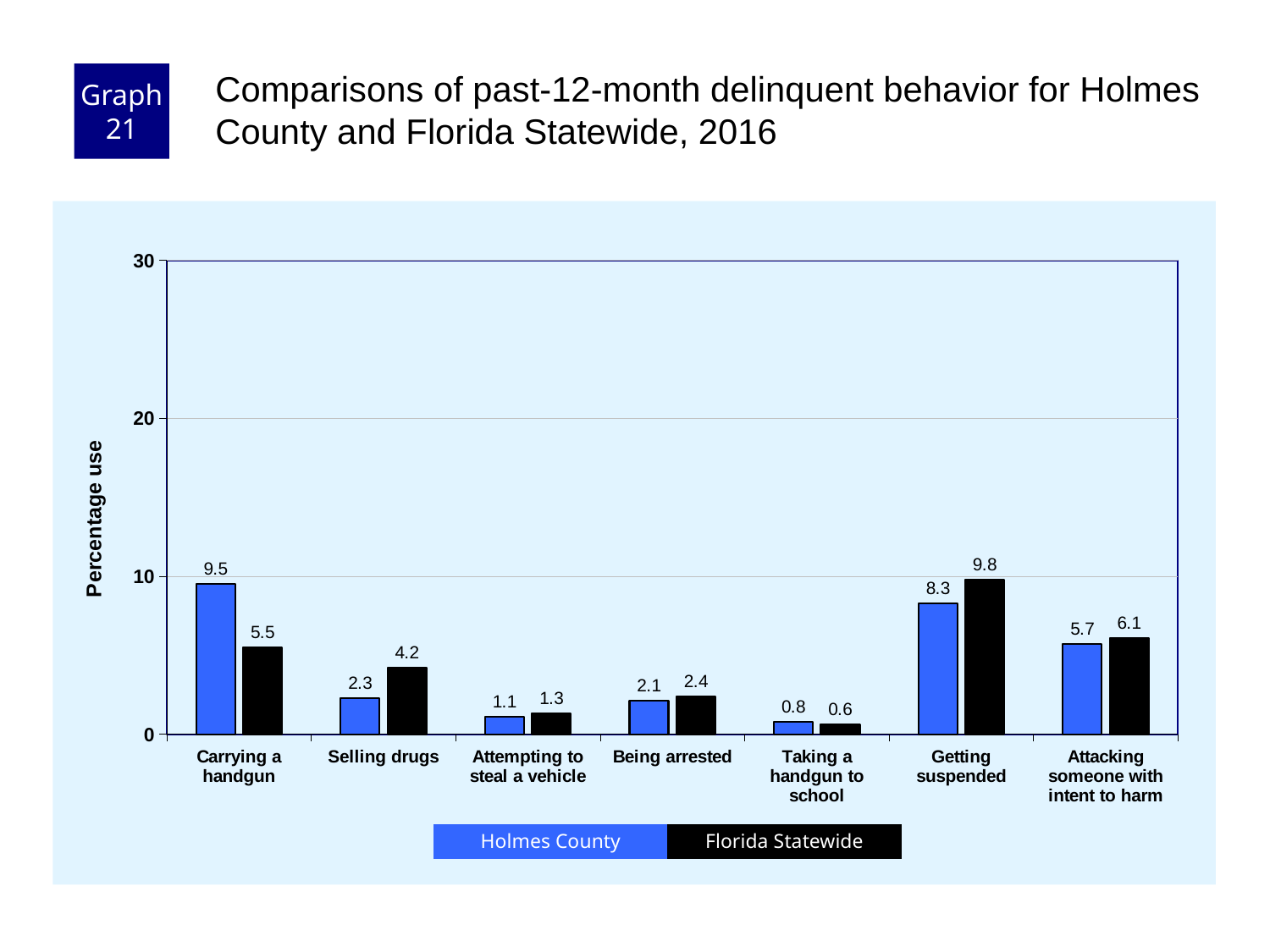
Which is larger for Getting suspended: Holmes County or Florida Statewide? Florida Statewide How many categories are shown on the x axis? 7 What kind of chart is shown on the slide? Bar chart Is the Florida Statewide value for Carrying a handgun greater or less than 10? less What is the difference between the Florida Statewide and Holmes County values for Selling drugs? 1.9 What is the difference between the Holmes County and Florida Statewide values for Carrying a handgun? 4.0 What is the Holmes County value for Carrying a handgun? 9.5 Which category has the highest Holmes County value? Carrying a handgun What is the Holmes County value for Taking a handgun to school? 0.8 What is the Florida Statewide value for Getting suspended? 9.8 Which category has the lowest Florida Statewide value? Taking a handgun to school How many series does the legend list? 2